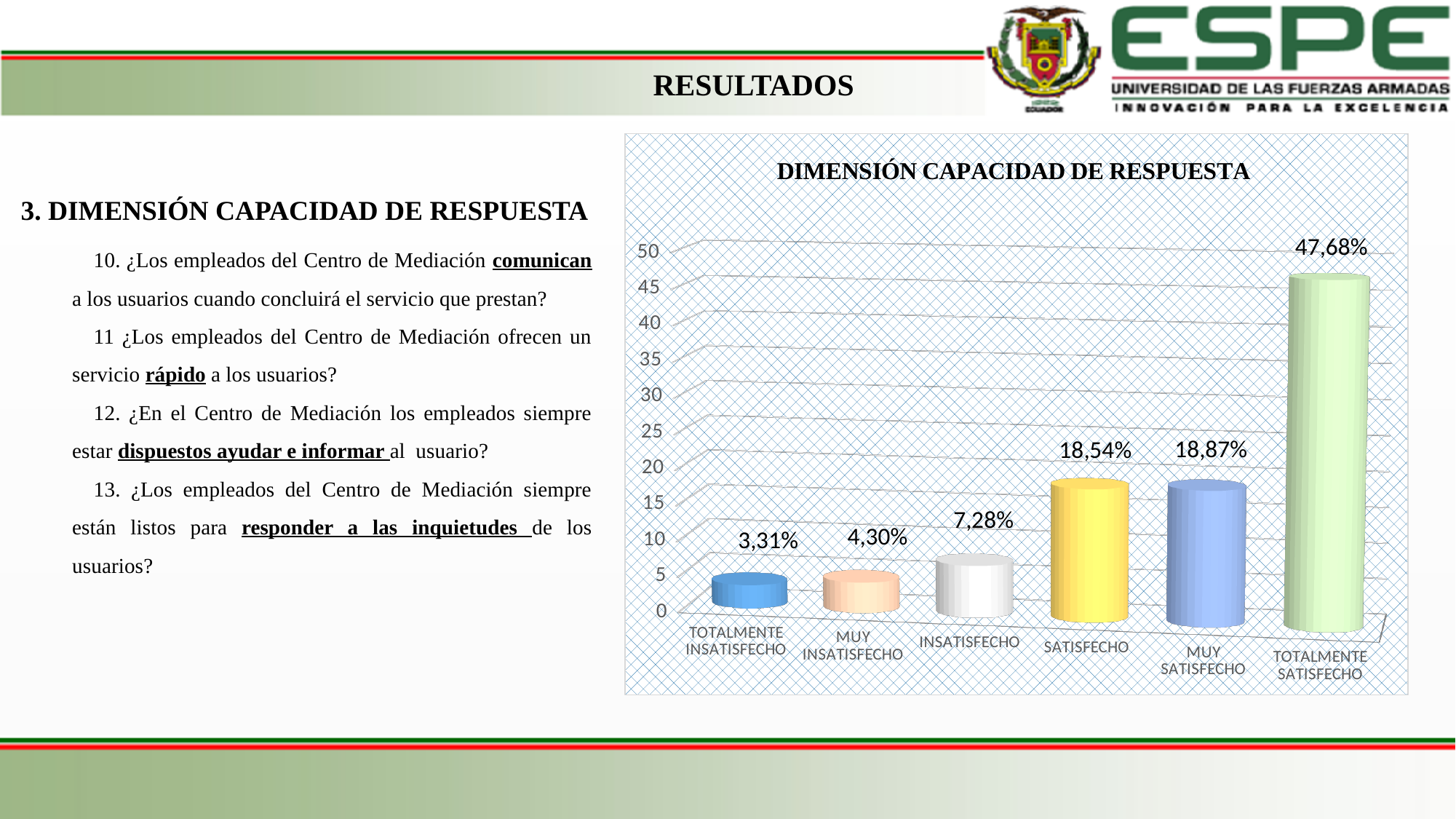
How many categories are shown on the chart? 6 What is the title of the chart? DIMENSIÓN CAPACIDAD DE RESPUESTA Do the values rise or fall from left to right along the x axis? Rise Which category has the highest value? TOTALMENTE SATISFECHO What is the difference between the values for TOTALMENTE SATISFECHO and MUY SATISFECHO? 28,81% Which category has the lowest value? TOTALMENTE INSATISFECHO What is the value for TOTALMENTE SATISFECHO? 47,68% What is the value for TOTALMENTE INSATISFECHO? 3,31% What is the value for INSATISFECHO? 7,28% What kind of chart is shown on the slide? Bar chart Which is larger, the value for MUY INSATISFECHO or the value for INSATISFECHO? INSATISFECHO What is the value for SATISFECHO? 18,54%